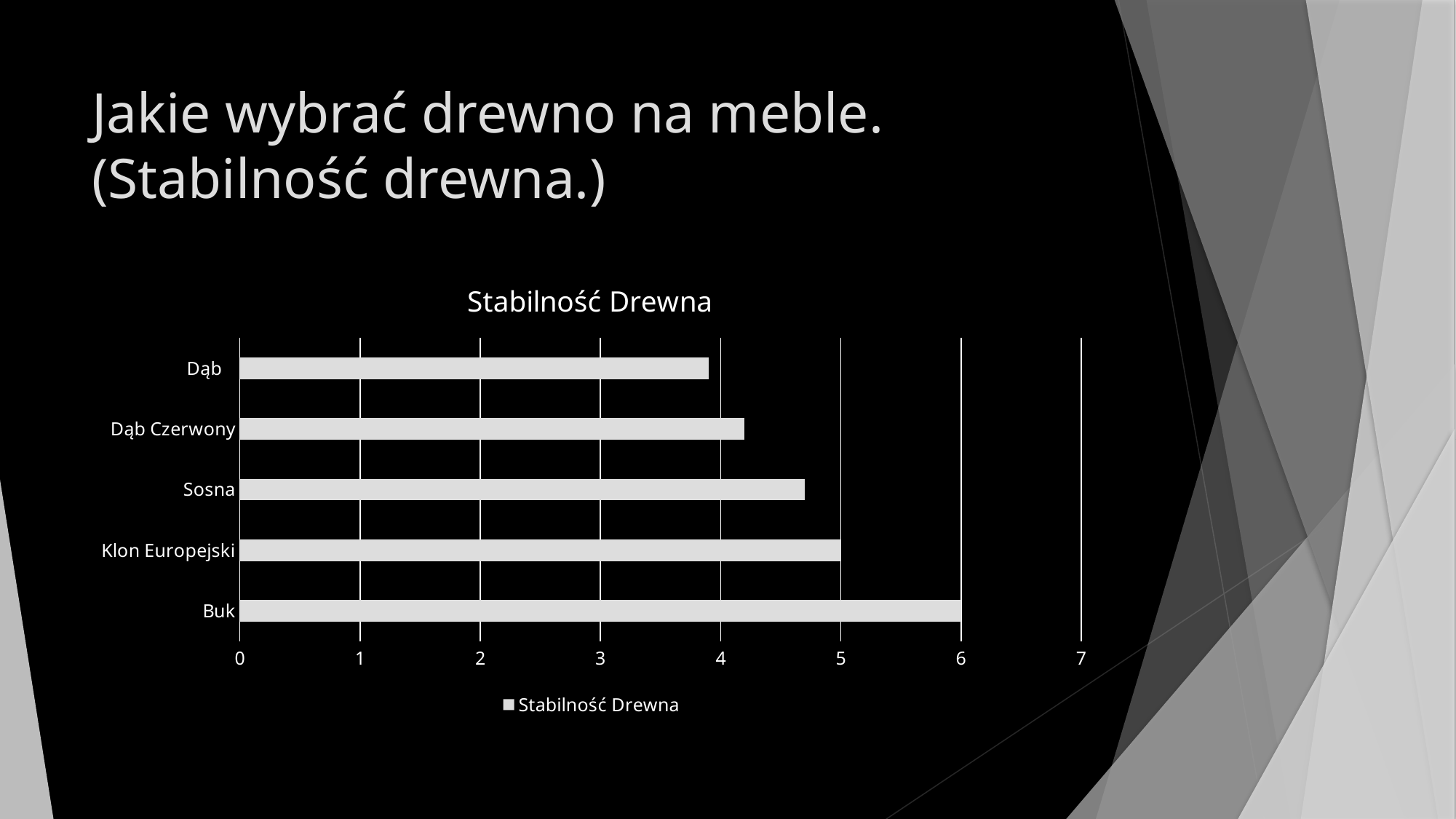
Which category has the highest value? Buk How many categories are plotted in the chart? 5 Which has a larger value, Sosna or Dąb Czerwony? Sosna What is the title of the chart? Stabilność Drewna What is the value for Klon Europejski? 5 What kind of chart is shown on the slide? bar chart Which category has the lowest value? Dąb Is the value for Dąb Czerwony greater or less than 4? greater Is the value for Dąb greater or less than 4? less How many series does the legend list? 1 What is the value for Buk? 6 What is the difference between the values for Buk and Klon Europejski? 1